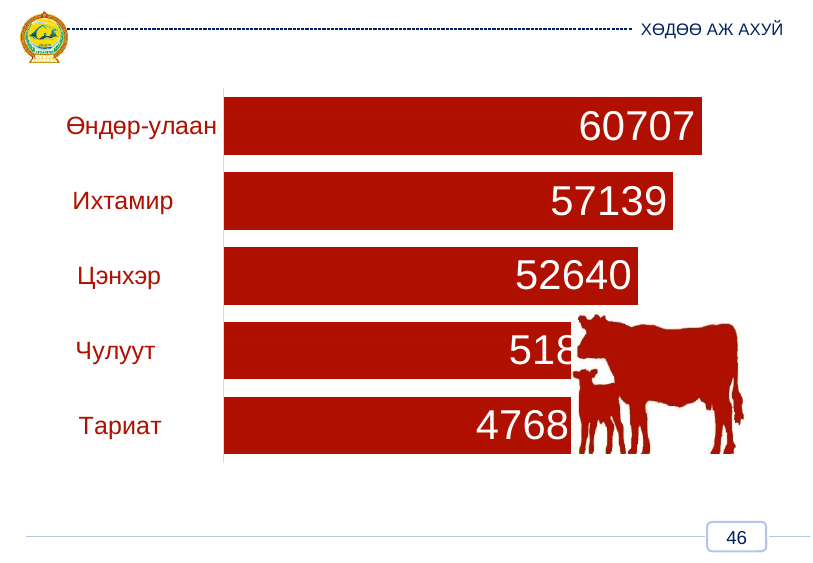
How many categories are shown in the chart? 5 What is the difference between the values for Өндөр-улаан and Ихтамир? 3568 What is the difference between the values for Ихтамир and Цэнхэр? 4499 Which is larger, the value for Ихтамир or the value for Цэнхэр? Ихтамир Which category has the highest value? Өндөр-улаан What kind of chart is shown on the slide? Bar chart Do the values rise or fall going from the top bar to the bottom bar? Fall What is the value for Ихтамир? 57139 What colour are the bars in the chart? Red Which category has the lowest value? Тариат What is the value for Өндөр-улаан? 60707 What is the value for Цэнхэр? 52640